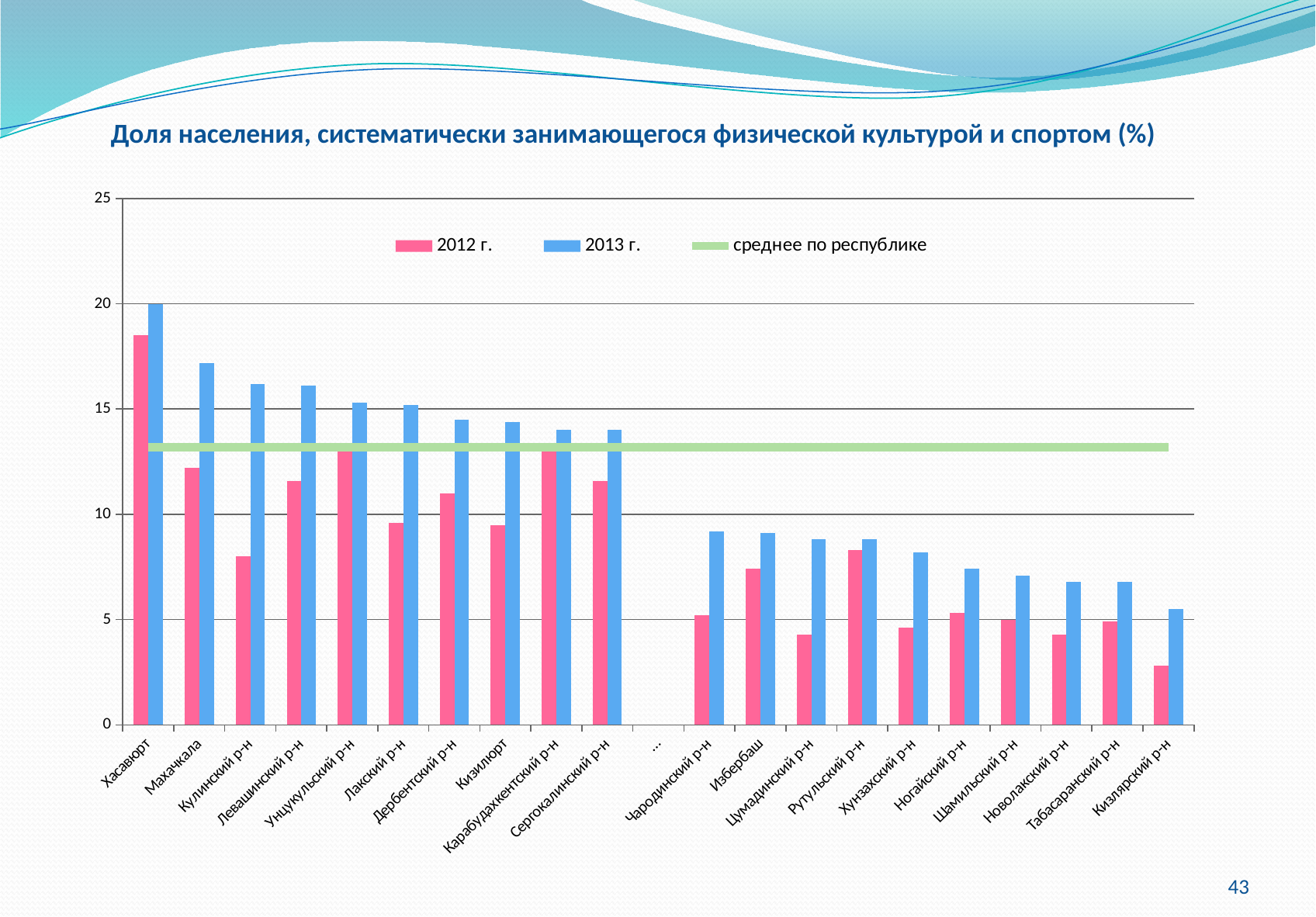
Is the 2012 г. value for Хасавюрт greater or less than 15? greater What kind of chart is shown on the slide? bar chart Which category has the lowest value for the 2012 г. series? Кизлярский р-н Which is larger: the 2012 г. value for Хасавюрт or the 2012 г. value for Махачкала? Хасавюрт Is the 2013 г. value for Чародинский р-н greater or less than 10? less Is the 2012 г. value for Кизлярский р-н greater or less than 5? less How many series does the legend list? 3 What is the title of the chart? Доля населения, систематически занимающегося физической культурой и спортом (%) Which is larger: the 2013 г. value for Махачкала or the 2013 г. value for Избербаш? Махачкала Do the 2013 г. values generally rise or fall from left to right along the x axis? fall Which category has the highest value for the 2013 г. series? Хасавюрт